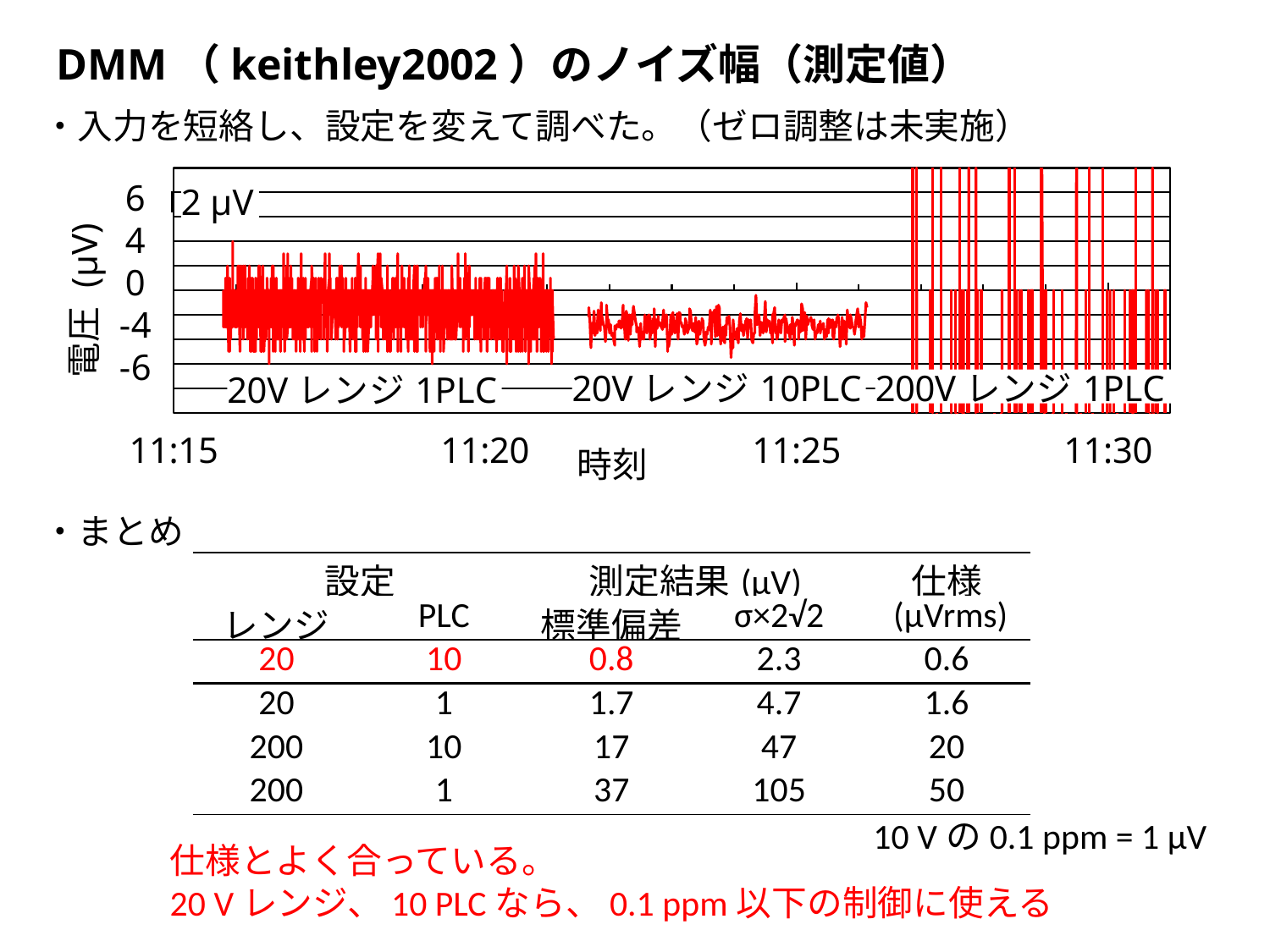
Which labeled setting on the chart shows the smallest noise amplitude? 20V レンジ 10PLC Which setting is plotted in the middle segment of the chart, between about 11:21 and 11:26? 20V レンジ 10PLC What is the last time tick shown on the horizontal axis of the chart? 11:30 Does the noise amplitude on the chart increase or decrease when moving from the 20V レンジ 10PLC segment to the 200V レンジ 1PLC segment? increase How many measurement settings (segments) are labeled on the chart? 3 Which setting shows a wider noise band on the chart, 20V レンジ 1PLC or 20V レンジ 10PLC? 20V レンジ 1PLC What kind of chart is shown on the slide? line chart What is the highest tick value shown on the vertical axis of the chart? 6 What is the label of the vertical axis of the chart? 電圧 (μV) What is the first time tick shown on the horizontal axis of the chart? 11:15 Which labeled setting on the chart shows the largest noise amplitude? 200V レンジ 1PLC What is the label of the horizontal axis of the chart? 時刻